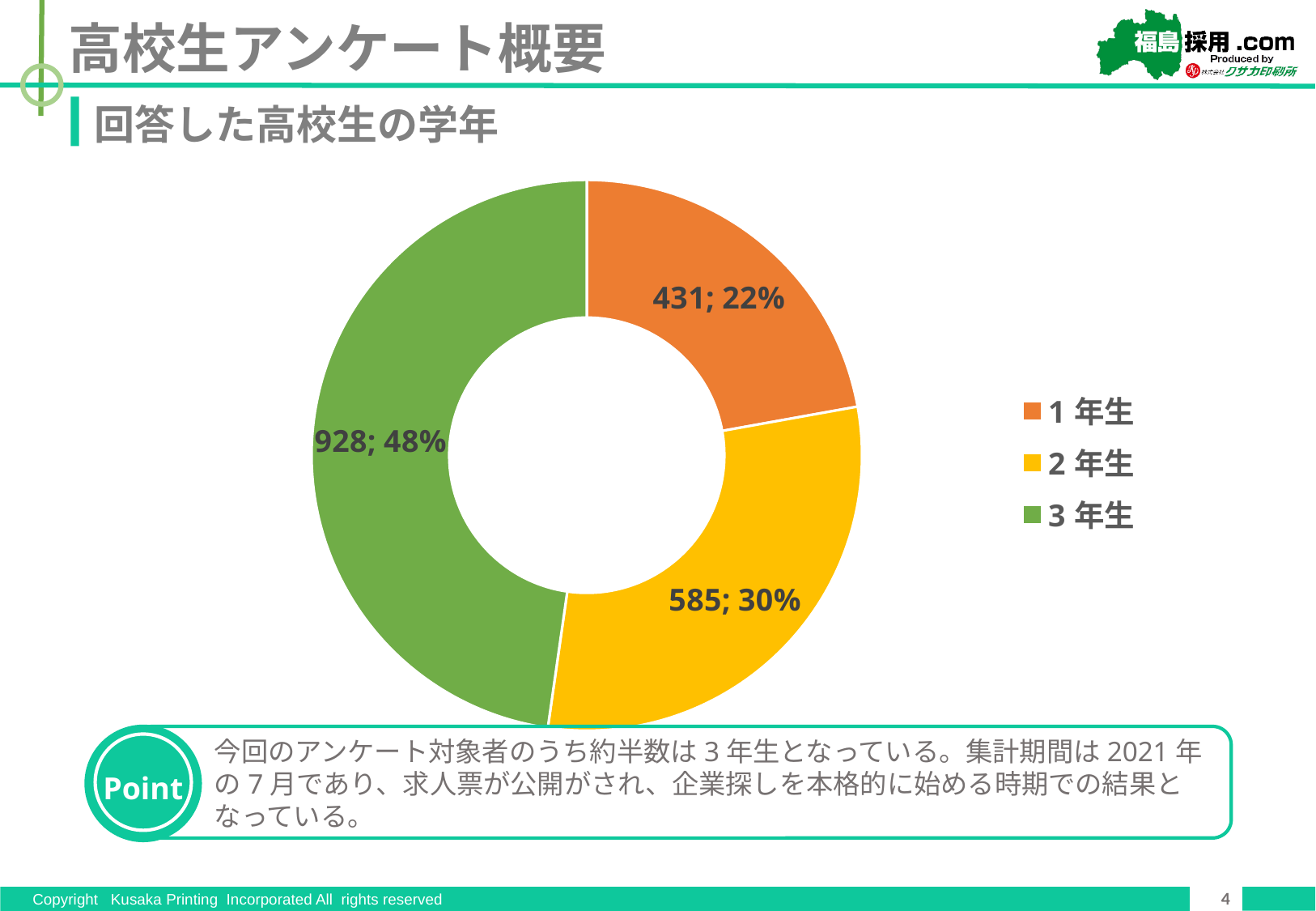
Which grade has the smallest number of respondents? 1年生 What share of respondents were 1年生? 22% What kind of chart is shown on the slide? Pie chart (doughnut) What colour represents 2年生 in the chart? Yellow Which has more respondents, 2年生 or 1年生? 2年生 What share of respondents were 3年生? 48% How many categories does the chart show? 3 Which grade has the largest number of respondents? 3年生 How many respondents were 1年生 (first-year students)? 431 What is the difference between the number of 3年生 and 2年生 respondents? 343 How many respondents were 2年生 (second-year students)? 585 How many respondents were 3年生 (third-year students)? 928